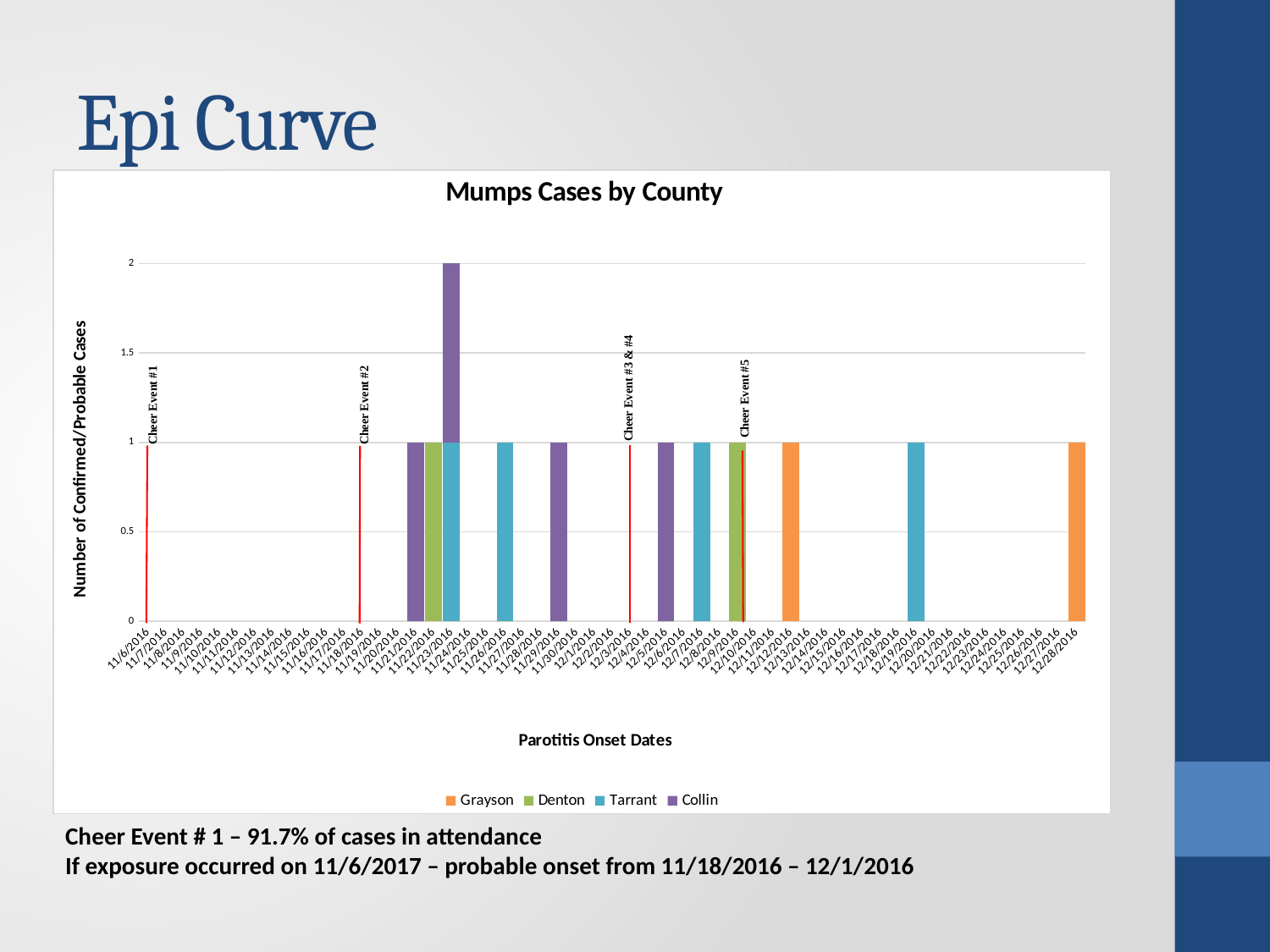
Which is larger: the tallest Collin bar or the Tarrant bar on 12/19/2016? the tallest Collin bar What type of chart is shown on the slide? bar chart How many series does the legend of the Mumps Cases by County chart list? 4 What is the highest number of cases shown for a single onset date in the Mumps Cases by County chart? 2 Which county does the bar on 11/22/2016 belong to? Denton Which county has the tallest bar in the Mumps Cases by County chart? Collin What is the label of the x axis of the chart? Parotitis Onset Dates What is the difference between the tallest Collin bar and the Denton bar on 11/22/2016? 1 What is the title of the chart? Mumps Cases by County What is the value of the Grayson bar on 12/28/2016? 1 Which county does the bar on 12/28/2016 belong to? Grayson Is the tallest bar in the Mumps Cases by County chart greater or less than 1.5? greater